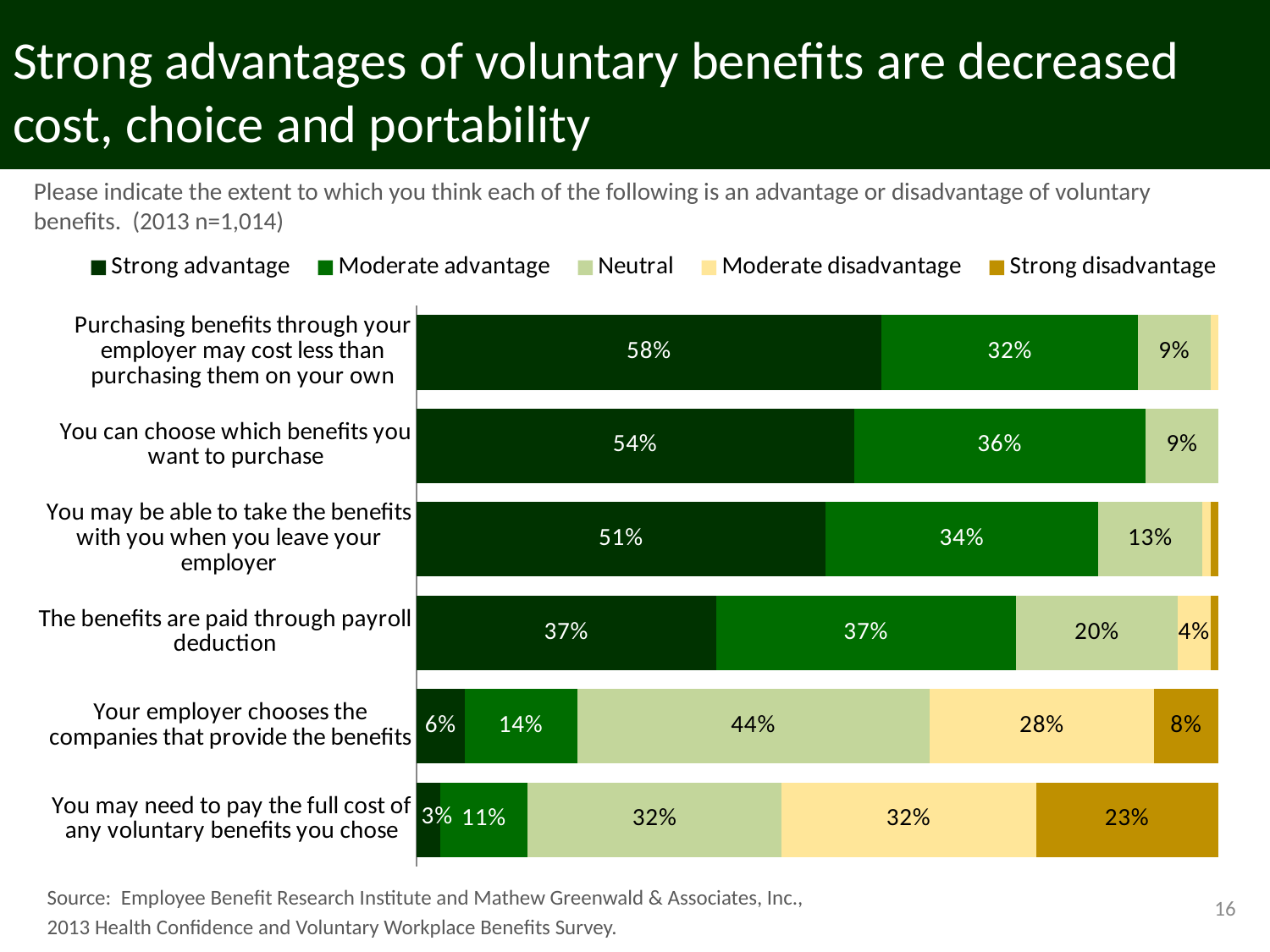
What is the total of the printed values for "Your employer chooses the companies that provide the benefits"? 100% How many series does the legend list? 5 Which has a larger Moderate advantage share: "You can choose which benefits you want to purchase" or "You may be able to take the benefits with you when you leave your employer"? You can choose which benefits you want to purchase What percentage rated "You may need to pay the full cost of any voluntary benefits you chose" as a Strong disadvantage? 23% How many items (categories) are shown in the chart? 6 What type of chart is shown on the slide? Stacked bar chart What percentage rated "Purchasing benefits through your employer may cost less than purchasing them on your own" as a Strong advantage? 58% Which item has the highest Strong advantage percentage? Purchasing benefits through your employer may cost less than purchasing them on your own What is the difference in Strong advantage percentage between "Purchasing benefits through your employer may cost less" and "You can choose which benefits you want to purchase"? 4 percentage points Which item has the lowest Strong advantage percentage? You may need to pay the full cost of any voluntary benefits you chose What is the Moderate disadvantage value for "Your employer chooses the companies that provide the benefits"? 28% What is the Neutral value for "Your employer chooses the companies that provide the benefits"? 44%